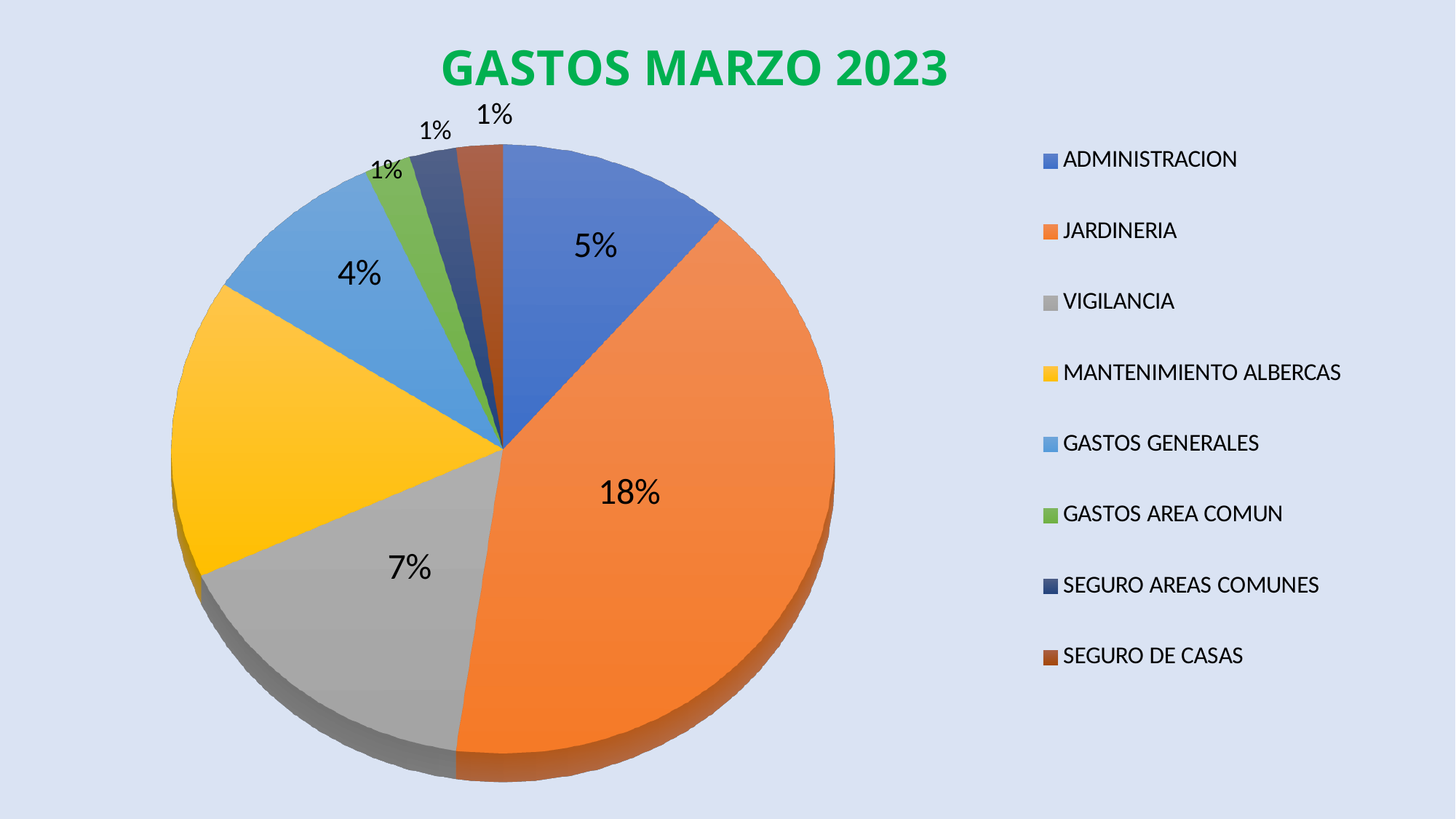
What percentage is shown for SEGURO DE CASAS? 1% How many categories does the legend list? 8 Which category has the largest slice of the pie? JARDINERIA What percentage is shown for GASTOS GENERALES? 4% What colour is the JARDINERIA slice? Orange What percentage is shown for ADMINISTRACION? 5% What is the title of the chart? GASTOS MARZO 2023 What percentage is shown for VIGILANCIA? 7% What type of chart is shown on the slide? Pie chart What percentage is shown for JARDINERIA? 18% Which is larger, the slice for JARDINERIA or the slice for VIGILANCIA? JARDINERIA What is the difference in percentage points between JARDINERIA and VIGILANCIA? 11